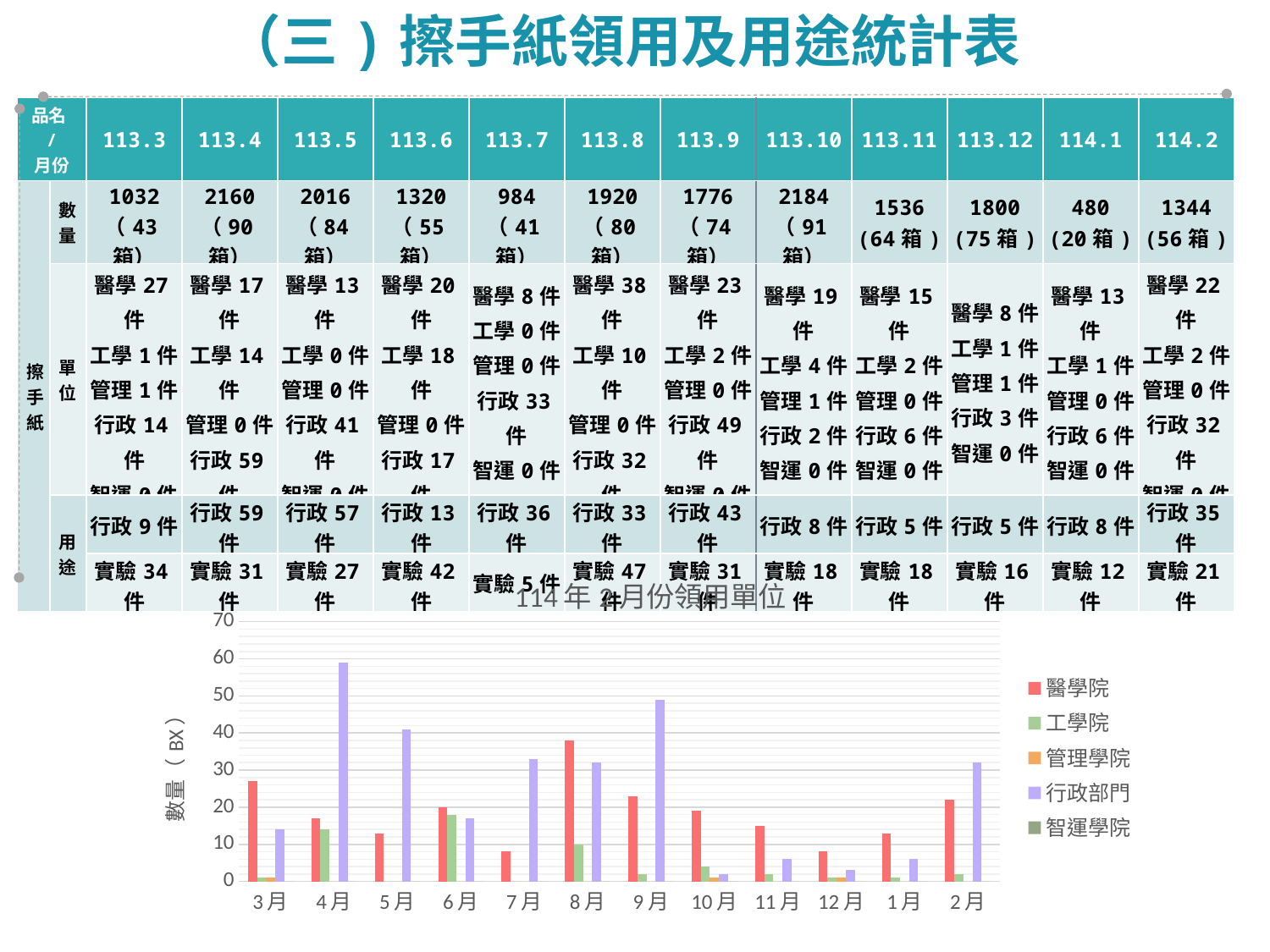
In the bar chart, is the value for 醫學院 in 7月 greater or less than 10? less In the bar chart, is the value for 醫學院 in 8月 greater or less than 30? greater What is the label of the y axis of the bar chart? 數量（BX） In the bar chart, which is larger in 9月: 醫學院 or 行政部門? 行政部門 How many series does the legend of the bar chart list? 5 In the bar chart, is the value for 行政部門 in 9月 greater or less than 40? greater In the bar chart, in which month is the 行政部門 bar the highest? 4月 In the bar chart, in which month is the 醫學院 bar the highest? 8月 How many months are shown along the x axis of the bar chart? 12 What kind of chart is shown at the bottom of the slide? bar chart In the bar chart, which is larger in 3月: 醫學院 or 行政部門? 醫學院